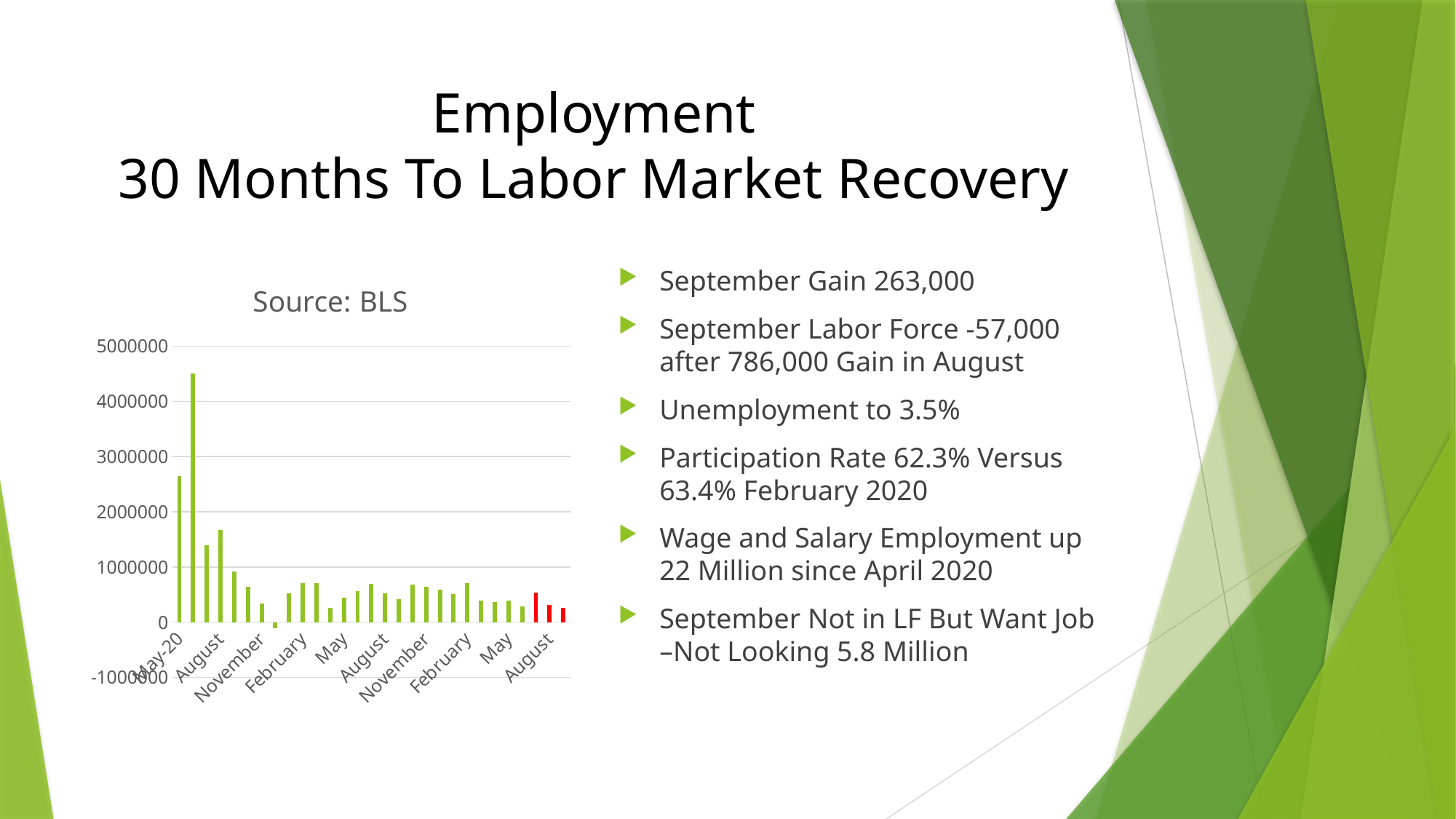
What is the title of the chart? Source: BLS Does any bar in the chart fall below zero? yes What kind of chart is shown on the slide? bar chart Is the first bar (May-20) taller or shorter than the bar immediately to its right? shorter Is the tallest bar in the chart greater or less than 4000000? greater Do the bars generally get taller or shorter moving from left to right across the chart? shorter Is the tallest bar in the chart greater or less than 5000000? less What is the highest value shown on the vertical axis? 5000000